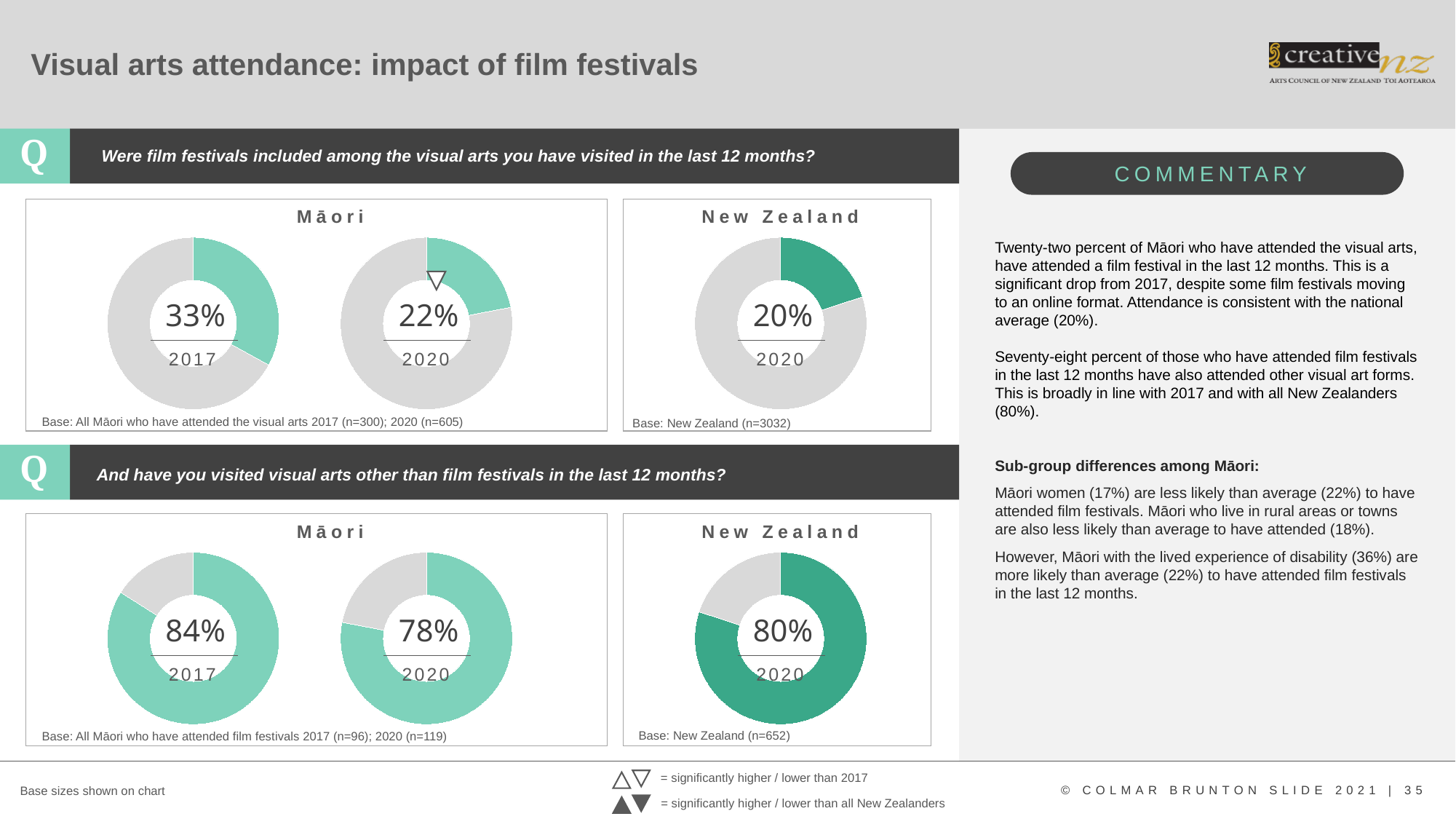
What type of chart is used to show the percentages on this slide? Donut (pie) chart In the top New Zealand chart (film festivals included), what percentage is shown for 2020? 20% In the bottom Māori chart (visual arts other than film festivals), what percentage is shown for 2017? 84% In the top Māori chart (film festivals included), what percentage is shown for 2017? 33% In the bottom New Zealand chart (visual arts other than film festivals), what percentage is shown for 2020? 80% In the top Māori chart, by how many percentage points did the value fall from 2017 to 2020? 11 percentage points In the bottom Māori chart (visual arts other than film festivals), what percentage is shown for 2020? 78% In the top Māori chart, which year has the higher value, 2017 or 2020? 2017 In the top row of charts, does the value for Māori 2020 or New Zealand 2020 appear larger? Māori 2020 How many donut charts are shown on the slide in total? 6 In the bottom Māori chart, what is the difference between the 2017 and 2020 values? 6 percentage points In the top Māori chart (film festivals included), what percentage is shown for 2020? 22%